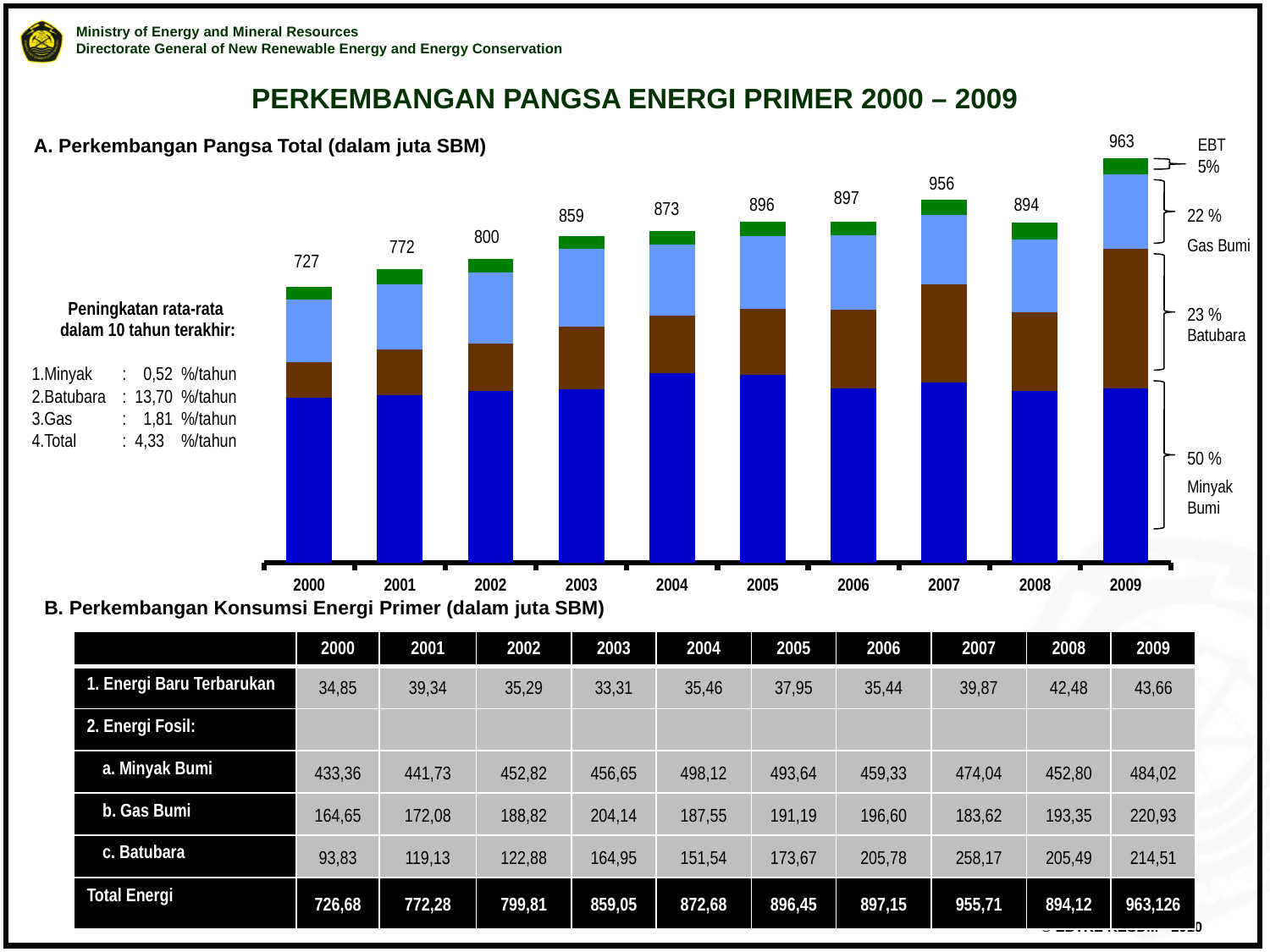
What is the total value shown above the bar for 2000? 727 Which year has the highest total in the chart? 2009 What is the difference between the total for 2009 and the total for 2000? 236 Which total is larger, 2003 or 2008? 2008 What kind of chart is shown on the slide? Stacked bar chart How many years (bars) are shown in the chart? 10 Which energy source is represented by the bottom (blue) segment of each bar? Minyak Bumi What is the difference between the total for 2007 and the total for 2008? 62 What is the total value shown above the bar for 2009? 963 Which year has the lowest total in the chart? 2000 Do the totals generally rise or fall from 2000 to 2007? Rise What is the total value shown above the bar for 2007? 956